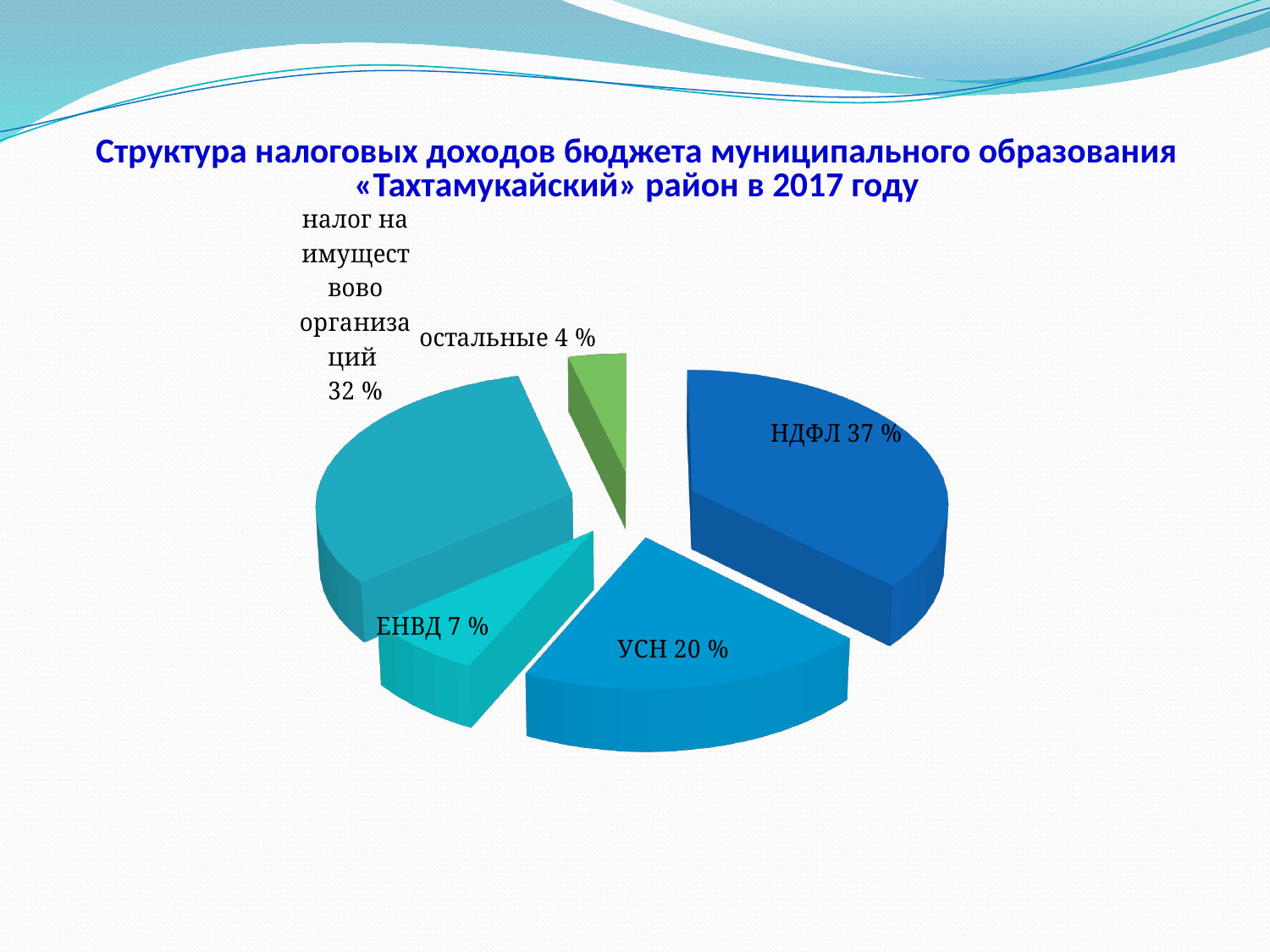
Which year does the chart title refer to? 2017 What share of tax revenues does налог на имущество организаций account for? 32 % Which slice of the pie chart is the largest? НДФЛ What share of tax revenues does УСН account for? 20 % How many slices does the pie chart have? 5 What share of tax revenues does НДФЛ account for? 37 % What kind of chart is shown on the slide? pie chart What share of tax revenues does остальные account for? 4 % What share of tax revenues does ЕНВД account for? 7 % Which is larger, the share of УСН or the share of ЕНВД? УСН Which slice of the pie chart is the smallest? остальные What is the difference in percentage points between НДФЛ and налог на имущество организаций? 5